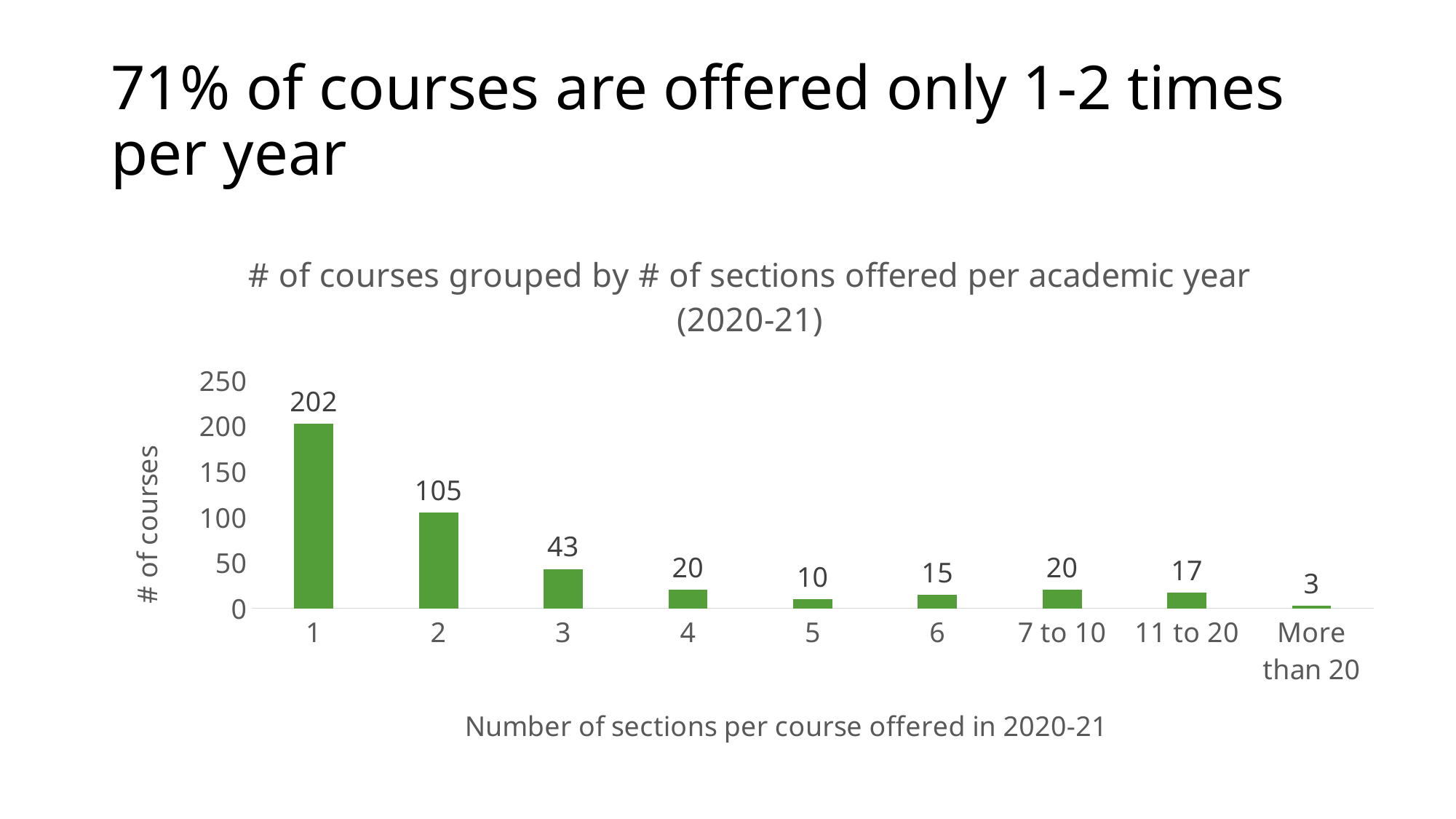
What is the label of the y axis? # of courses What is the difference between the number of courses with 1 section and the number with 2 sections? 97 How many categories are shown on the x axis? 9 Which has more courses: 3 sections or 7 to 10 sections? 3 How many courses were offered with 1 section per academic year? 202 Which category has the highest number of courses? 1 Which category has the lowest number of courses? More than 20 What is the number of courses with 2 sections offered? 105 How many courses had 11 to 20 sections? 17 How many courses had more than 20 sections? 3 What kind of chart is shown on the slide? Bar chart Is the value for 2 sections greater or less than 100? greater